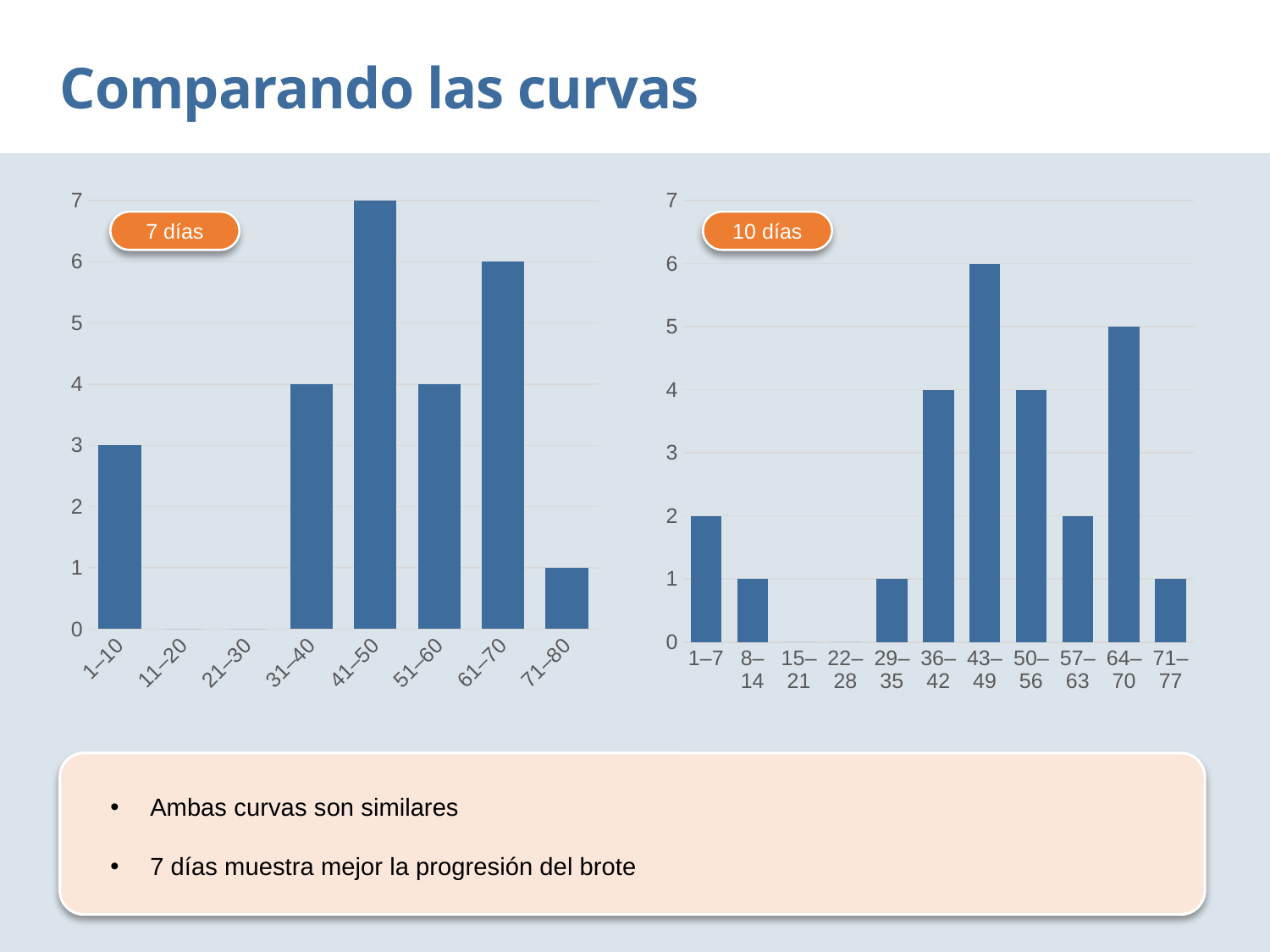
In the right chart (labelled 10 días), what is the value for the 43–49 category? 6 How many categories are shown on the x axis of the left chart (labelled 7 días)? 8 In the left chart (labelled 7 días), what is the difference between the values for 41–50 and 61–70? 1 In the right chart (labelled 10 días), which category has the highest value? 43–49 In the right chart (labelled 10 días), what is the value for the 64–70 category? 5 In the right chart (labelled 10 días), which is larger, the value for 1–7 or the value for 8–14? 1–7 How many categories are shown on the x axis of the right chart (labelled 10 días)? 11 In the left chart (labelled 7 días), which category has the highest value? 41–50 In the left chart (labelled 7 días), what is the value for the 1–10 category? 3 What type of chart is the left chart (labelled 7 días)? Bar chart In the left chart (labelled 7 días), what is the value for the 41–50 category? 7 In the right chart (labelled 10 días), what is the difference between the values for 43–49 and 57–63? 4